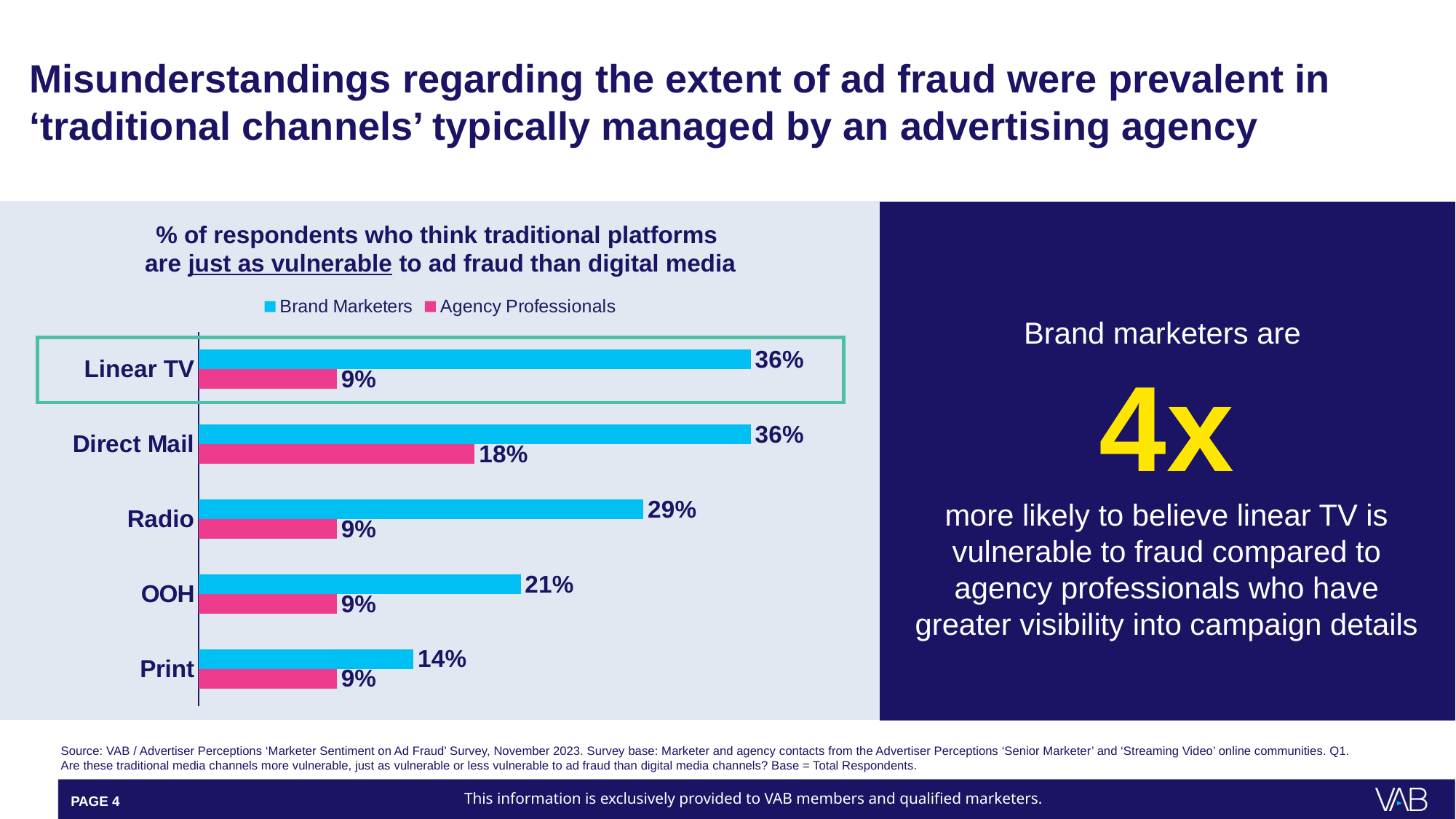
How many media channels are shown on the chart? 5 Which category has the highest Agency Professionals value? Direct Mail What is the Brand Marketers value for Radio? 29% What percentage of Agency Professionals think Direct Mail is just as vulnerable to ad fraud as digital media? 18% What percentage of Brand Marketers think Linear TV is just as vulnerable to ad fraud as digital media? 36% What kind of chart is shown on the slide? Bar chart Which is larger for Direct Mail: the Brand Marketers value or the Agency Professionals value? Brand Marketers How many series does the legend list? 2 What is the Brand Marketers value for OOH? 21% What is the difference between the Brand Marketers values for Radio and Print? 15 percentage points Which category has the lowest Brand Marketers value? Print What is the difference between the Brand Marketers and Agency Professionals values for Linear TV? 27 percentage points